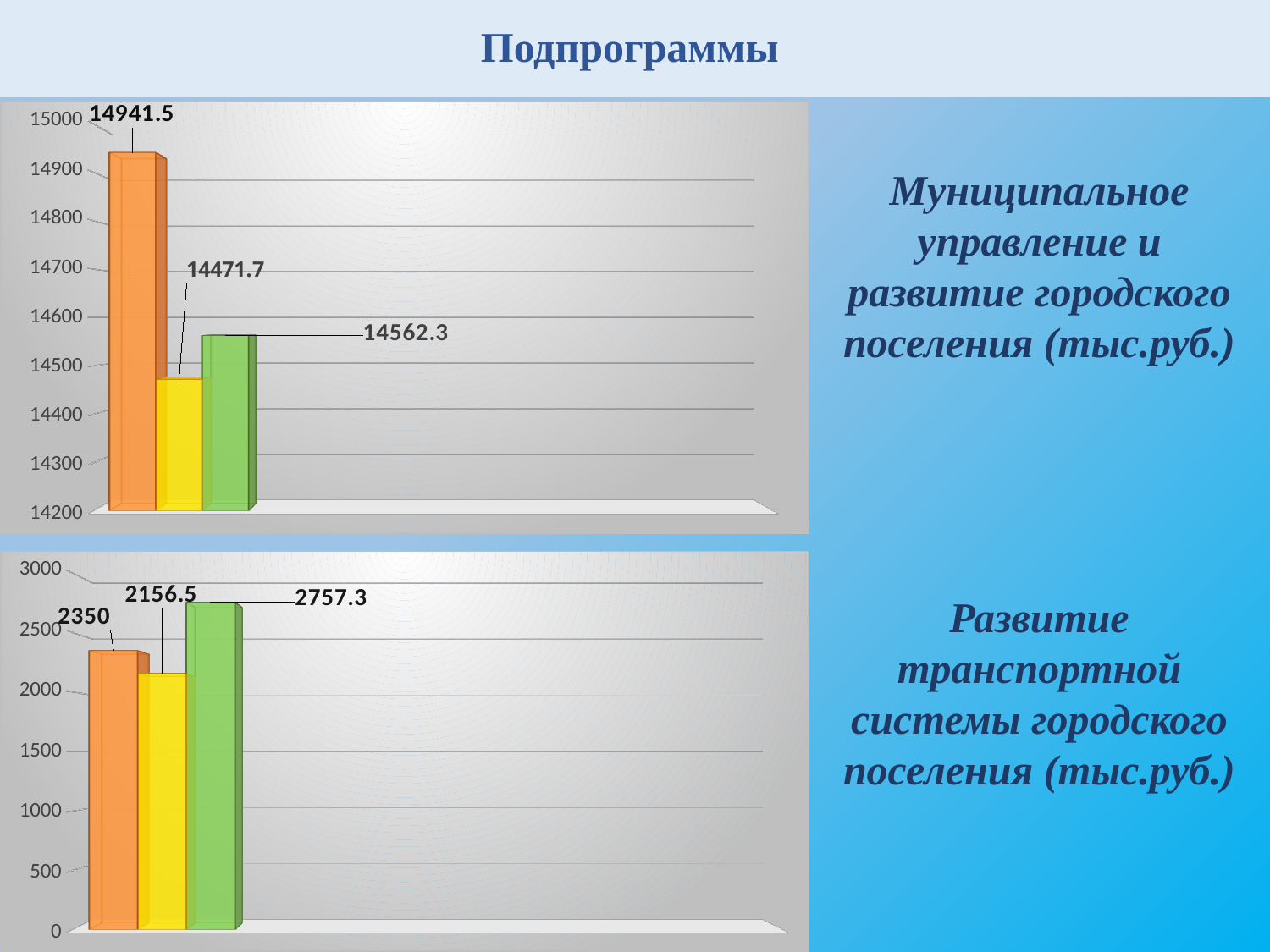
In the bottom chart (Развитие транспортной системы городского поселения), is the orange bar or the yellow bar larger? the orange bar In the top chart (Муниципальное управление и развитие городского поселения), what is the value shown on the orange bar? 14941.5 In the bottom chart (Развитие транспортной системы городского поселения), which bar has the highest value? the green bar (2757.3) In the bottom chart (Развитие транспортной системы городского поселения), what is the difference between the green bar and the yellow bar? 600.8 In the top chart (Муниципальное управление и развитие городского поселения), what is the value shown on the green bar? 14562.3 In the bottom chart (Развитие транспортной системы городского поселения), what is the value shown on the orange bar? 2350 In the top chart (Муниципальное управление и развитие городского поселения), how many bars are plotted? 3 In the top chart (Муниципальное управление и развитие городского поселения), what is the difference between the orange bar and the yellow bar? 469.8 In the bottom chart (Развитие транспортной системы городского поселения), what is the value shown on the green bar? 2757.3 What type of chart is the bottom chart (Развитие транспортной системы городского поселения)? bar chart In the top chart (Муниципальное управление и развитие городского поселения), what is the value shown on the yellow bar? 14471.7 In the top chart (Муниципальное управление и развитие городского поселения), which bar has the lowest value? the yellow bar (14471.7)